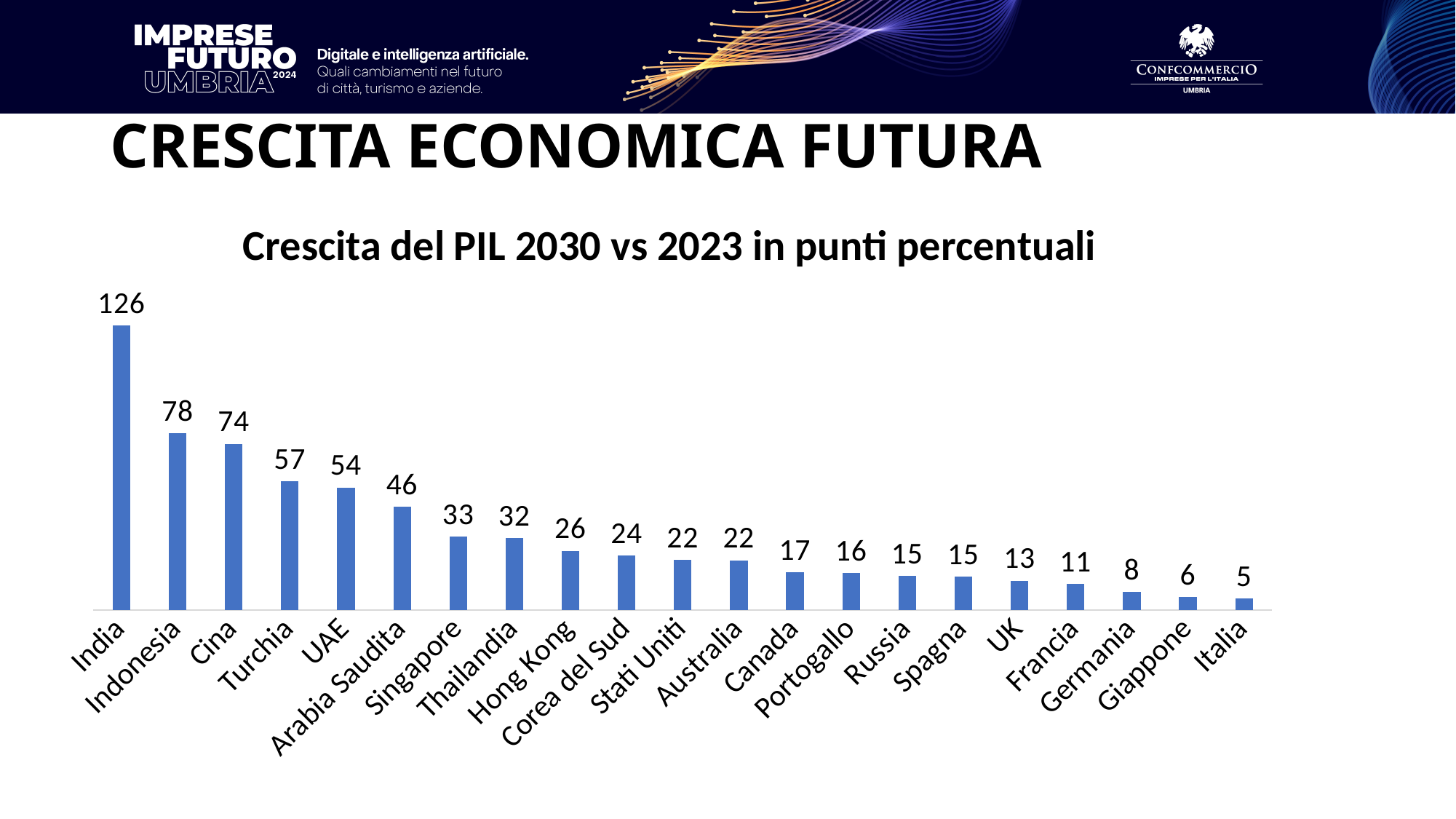
Which country has the highest value? India What is the difference between the values for Indonesia and Cina? 4 What is the value for Arabia Saudita? 46 What is the value for Italia? 5 Which has a larger value, Turchia or UAE? Turchia What kind of chart is shown? Bar chart What is the difference between the values for India and Italia? 121 How many countries are shown in the chart? 21 Which country has the lowest value? Italia What is the value for India? 126 What is the value for Canada? 17 What is the title of the chart? Crescita del PIL 2030 vs 2023 in punti percentuali